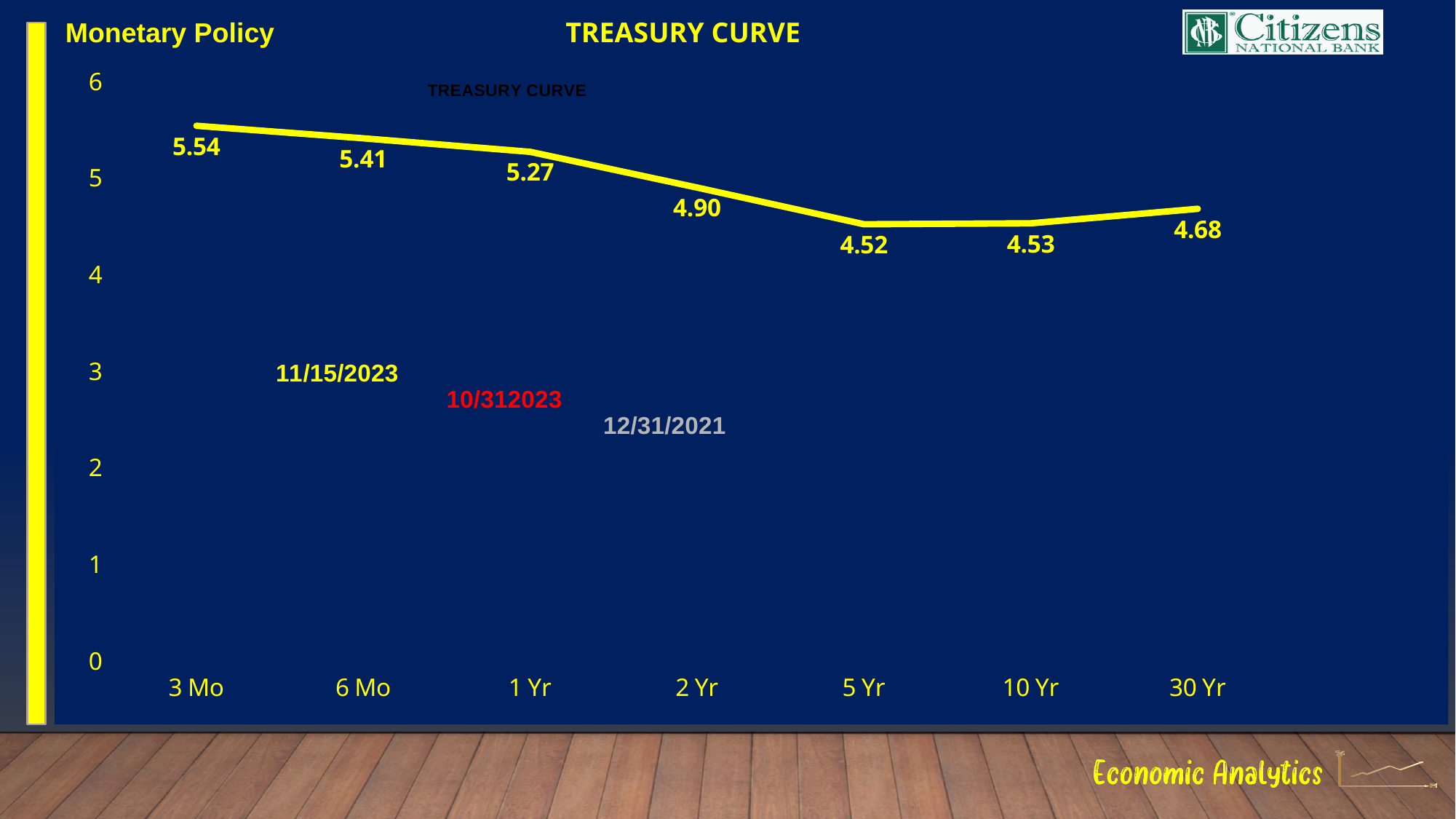
Is the value for 2 Yr greater or less than 5? less What is the difference between the 6 Mo value and the 1 Yr value? 0.14 How many maturities are plotted on the x axis of the Treasury Curve chart? 7 What is the value for 2 Yr on the Treasury Curve chart? 4.90 What is the value for 10 Yr on the Treasury Curve chart? 4.53 Do the values rise or fall from 3 Mo to 5 Yr? fall What is the difference between the 3 Mo value and the 5 Yr value? 1.02 What is the value for 30 Yr on the Treasury Curve chart? 4.68 What kind of chart is shown on the slide? line chart What is the value for 3 Mo on the Treasury Curve chart? 5.54 Which is larger, the value for 3 Mo or the value for 30 Yr? 3 Mo Which maturity has the highest value on the Treasury Curve chart? 3 Mo